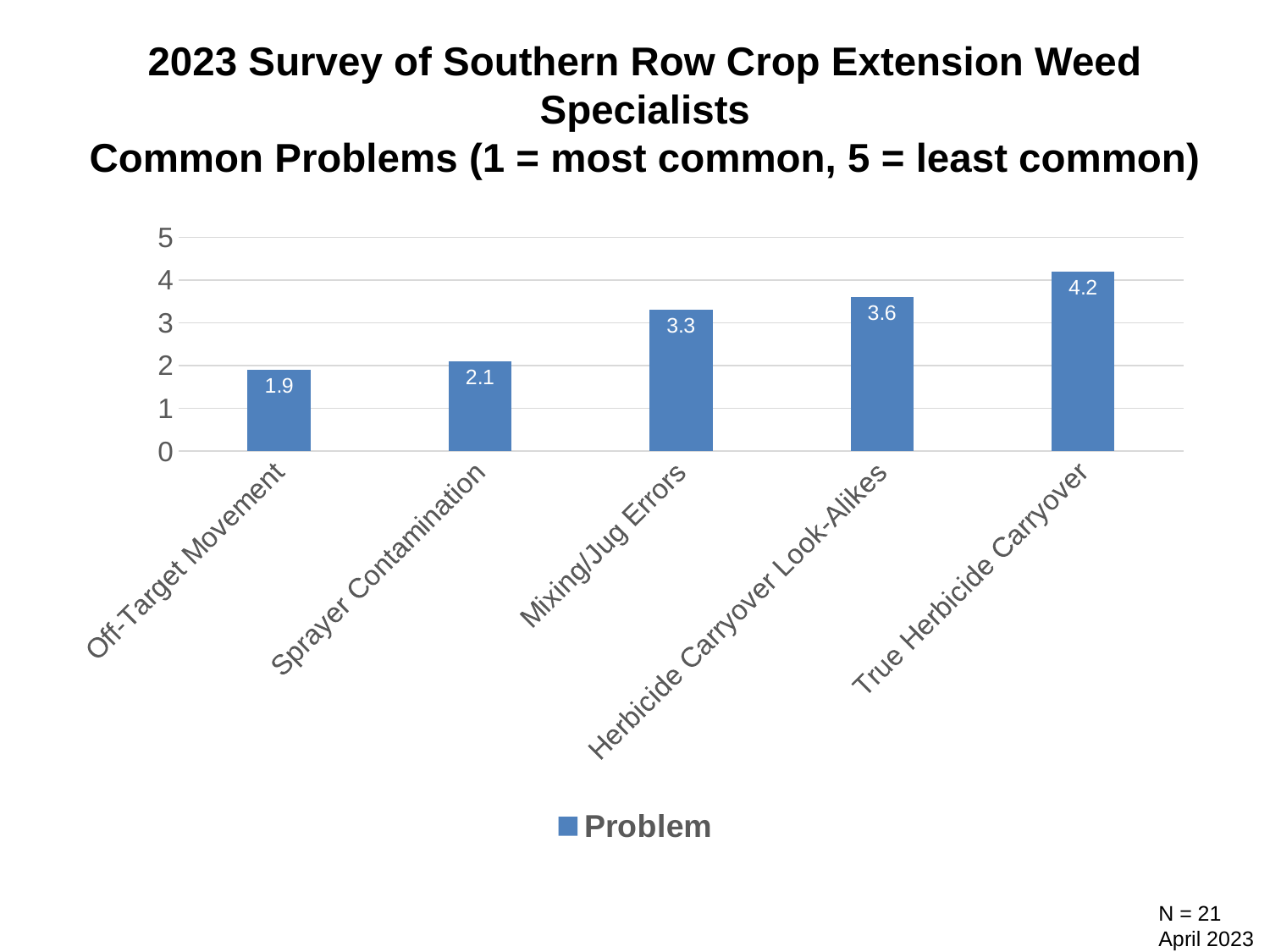
What is the difference between the values for True Herbicide Carryover and Off-Target Movement? 2.3 How many categories are shown on the chart? 5 Which is larger, the value for Sprayer Contamination or the value for Mixing/Jug Errors? Mixing/Jug Errors What is the name of the series listed in the legend? Problem What is the value for True Herbicide Carryover? 4.2 Which category has the lowest value? Off-Target Movement What is the value for Off-Target Movement? 1.9 Which category has the highest value? True Herbicide Carryover What kind of chart is shown on the slide? bar chart Is the value for Herbicide Carryover Look-Alikes greater or less than 3? greater What is the value for Mixing/Jug Errors? 3.3 What is the difference between the values for Herbicide Carryover Look-Alikes and Sprayer Contamination? 1.5